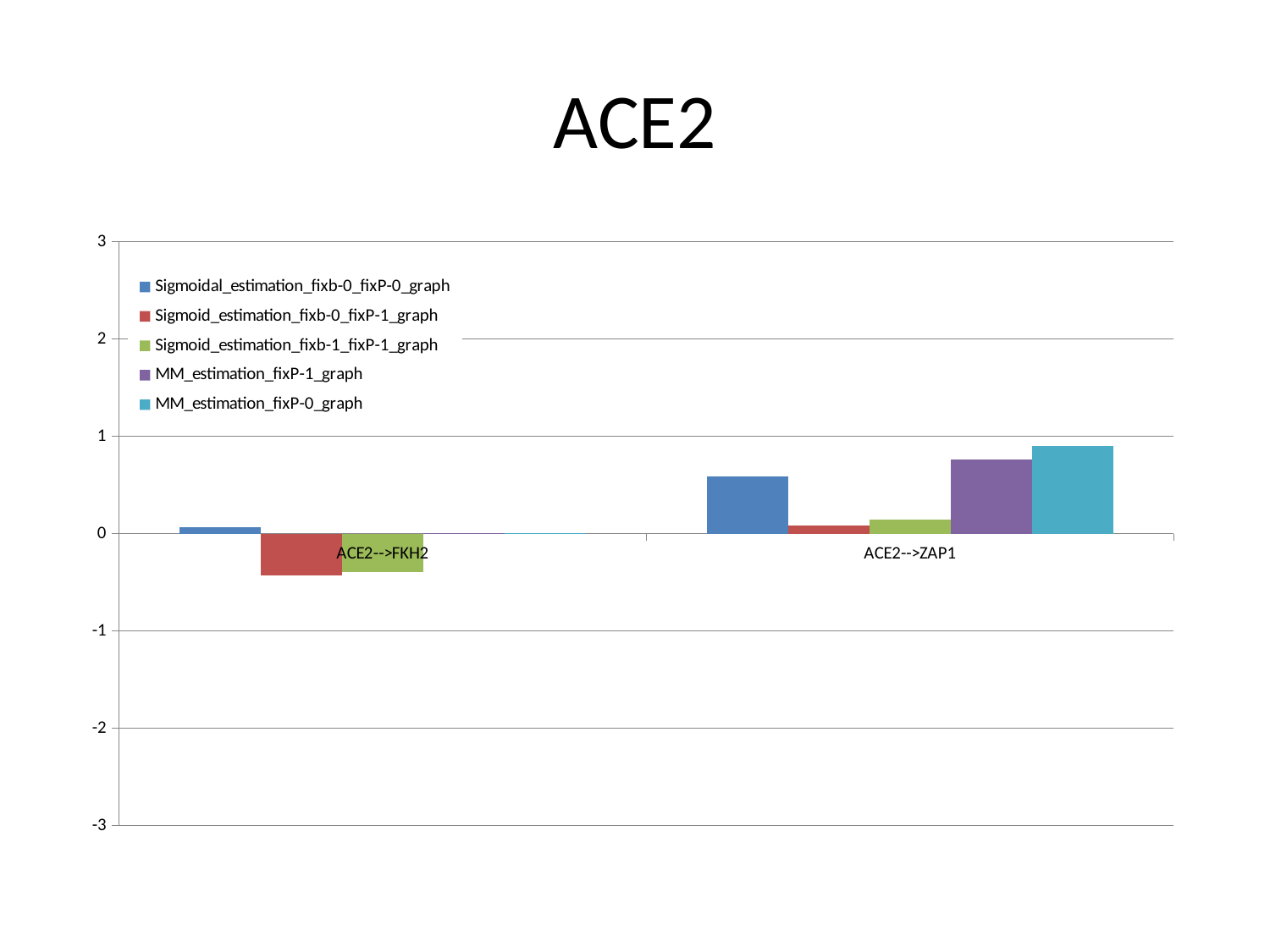
Which series is listed first in the legend? Sigmoidal_estimation_fixb-0_fixP-0_graph For ACE2-->ZAP1, which is larger, MM_estimation_fixP-1_graph or Sigmoid_estimation_fixb-1_fixP-1_graph? MM_estimation_fixP-1_graph What is the title of the chart? ACE2 How many categories are shown on the x axis? 2 What kind of chart is shown on the slide? bar chart Which series has the highest value for ACE2-->ZAP1? MM_estimation_fixP-0_graph Is the value of Sigmoidal_estimation_fixb-0_fixP-0_graph for ACE2-->ZAP1 greater or less than 0? greater How many series does the legend list? 5 For Sigmoidal_estimation_fixb-0_fixP-0_graph, which category has the larger value, ACE2-->FKH2 or ACE2-->ZAP1? ACE2-->ZAP1 Is the value of MM_estimation_fixP-0_graph for ACE2-->ZAP1 greater or less than 1? less Is the value of Sigmoid_estimation_fixb-0_fixP-1_graph for ACE2-->FKH2 greater or less than 0? less Which series has the lowest value for ACE2-->ZAP1? Sigmoid_estimation_fixb-0_fixP-1_graph